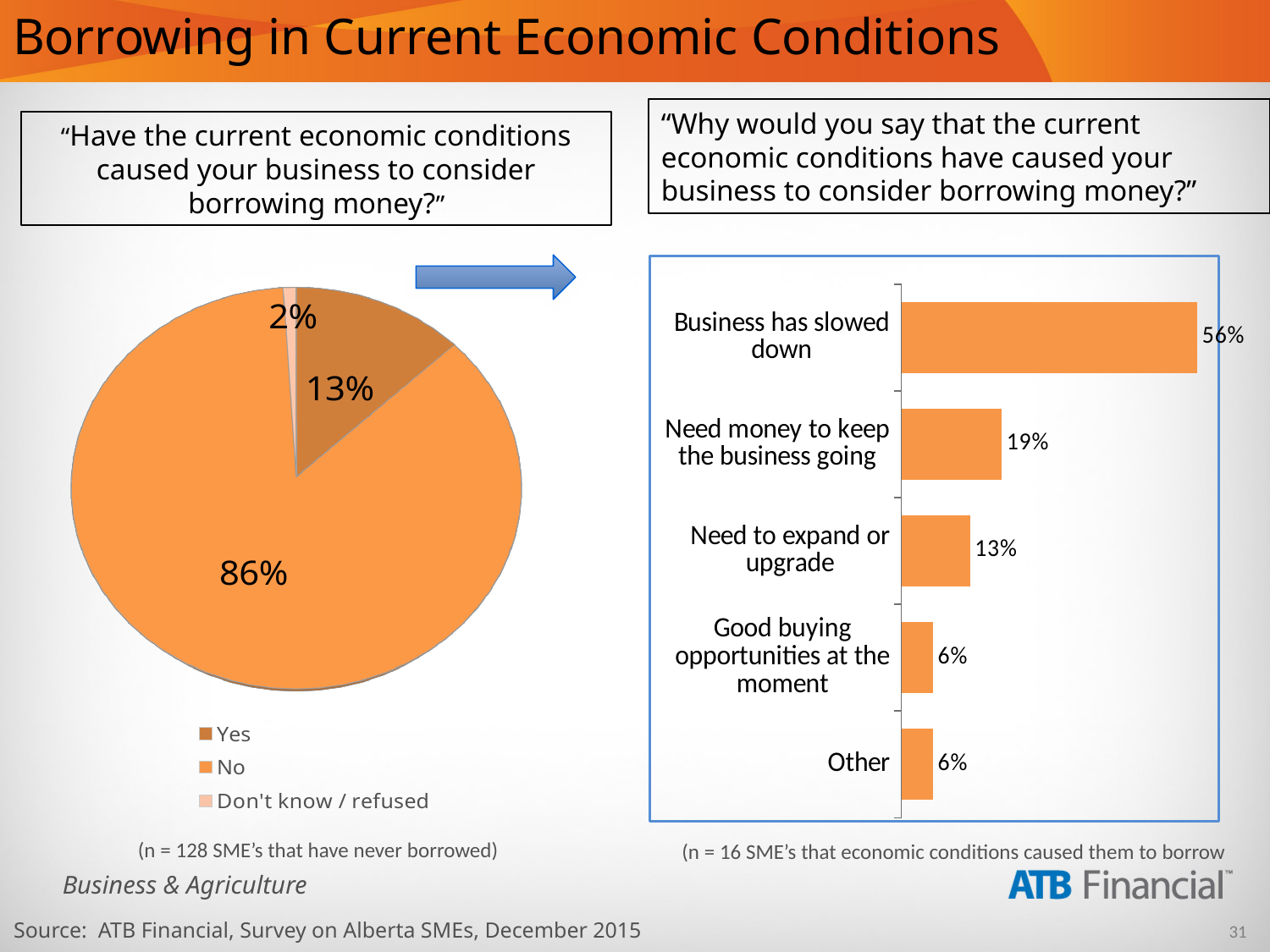
In the pie chart on the left, what percentage of respondents answered "Yes"? 13% In the pie chart on the left, what percentage of respondents answered "No"? 86% In the bar chart on the right, what is the value for "Business has slowed down"? 56% In the bar chart on the right, which reason has the highest value? Business has slowed down In the bar chart on the right, what is the difference between "Business has slowed down" and "Need money to keep the business going"? 37% In the bar chart on the right, what is the value for "Need money to keep the business going"? 19% In the pie chart on the left, how many categories does the legend list? 3 In the pie chart on the left, what percentage answered "Don't know / refused"? 2% In the bar chart on the right, how many reasons are shown? 5 In the pie chart on the left, which response has the largest slice? No In the bar chart on the right, what is the value for "Need to expand or upgrade"? 13% What type of chart is shown on the right side of the slide? Bar chart